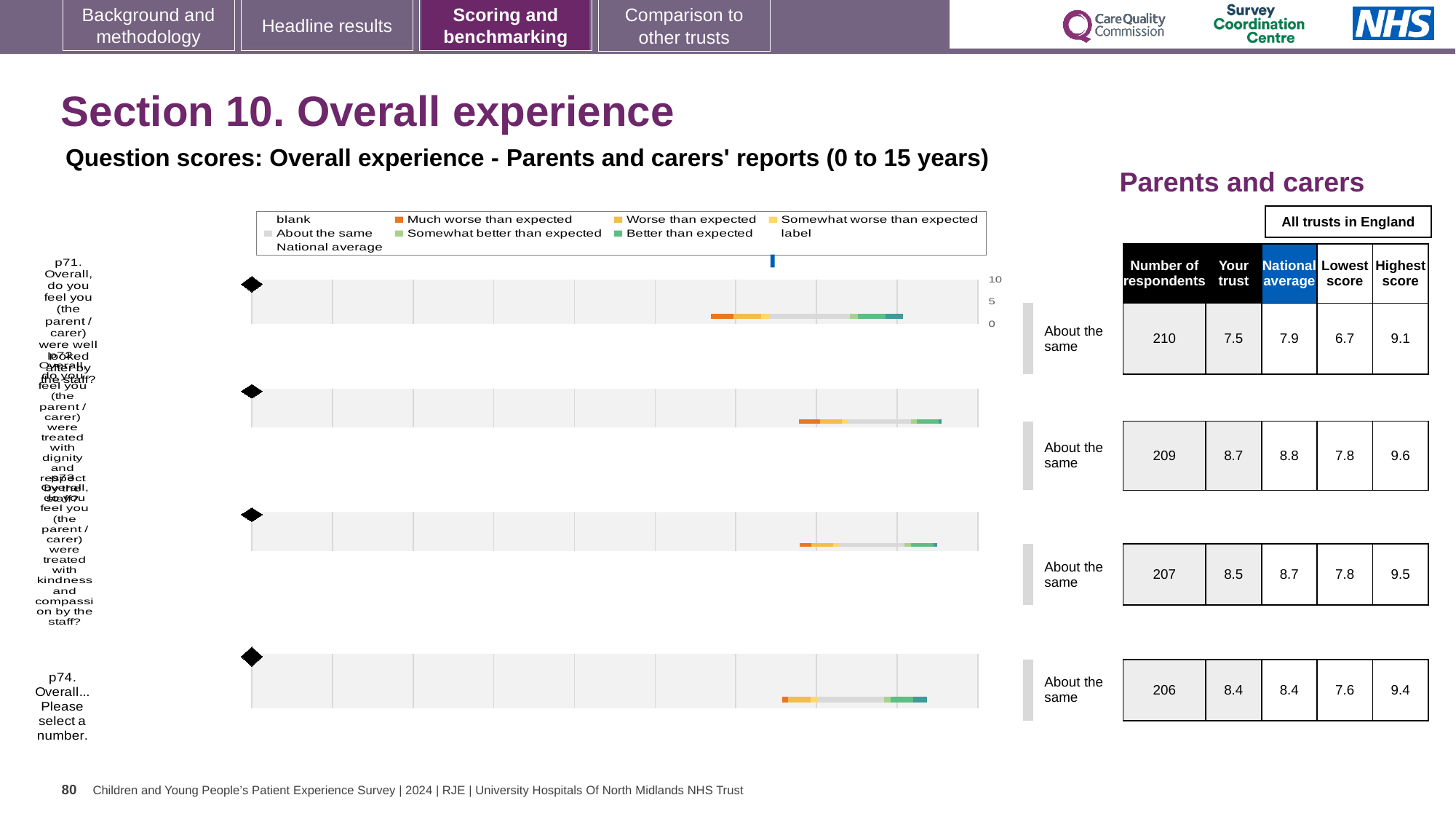
In the table beside the chart, how many respondents are listed for p74 (Overall... Please select a number)? 206 Which row in the table has the highest 'Your trust' score? the second row (8.7) What benchmark category is shown next to every bar in the chart? About the same In the table beside the chart, what is the Highest score for p74? 9.4 In the table beside the chart, what is the Lowest score for the second row from the top? 7.8 What kind of chart is used to show the question scores on this slide? bar chart In the table beside the chart, what is the 'Your trust' score for p71 (Overall, do you feel you were well looked after by the staff)? 7.5 For p71, what is the difference between the National average and the 'Your trust' score? 0.4 How many question rows (bars) are plotted in the chart? 4 What is the title of the chart section above the bars? Question scores: Overall experience - Parents and carers' reports (0 to 15 years) In the table beside the chart, what is the National average for p71? 7.9 For p71, which is larger: the 'Your trust' score or the National average? National average